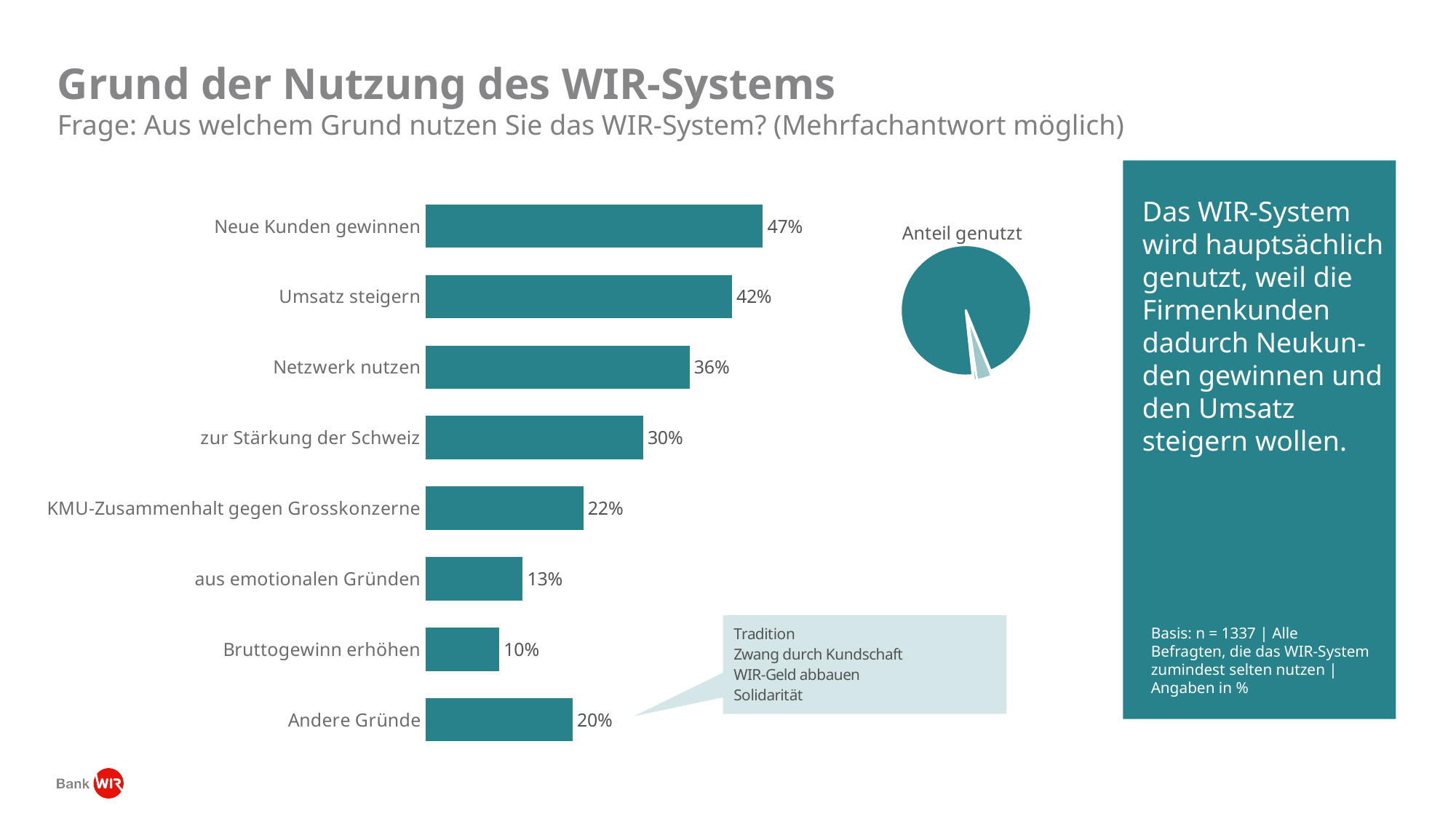
In the bar chart, what is the difference between "KMU-Zusammenhalt gegen Grosskonzerne" and "aus emotionalen Gründen"? 9% How many categories does the bar chart show? 8 What is the title of the small chart next to the bar chart? Anteil genutzt In the bar chart, what is the difference between "Umsatz steigern" and "Netzwerk nutzen"? 6% In the bar chart, what is the value for "Andere Gründe"? 20% In the bar chart, which is larger: "Andere Gründe" or "aus emotionalen Gründen"? Andere Gründe What kind of chart is the chart on the left of the slide? Bar chart In the bar chart, what is the value for "Neue Kunden gewinnen"? 47% What kind of chart is the small chart titled "Anteil genutzt"? Pie chart In the bar chart, which category has the lowest value? Bruttogewinn erhöhen In the bar chart, which category has the highest value? Neue Kunden gewinnen In the bar chart, what is the value for "zur Stärkung der Schweiz"? 30%